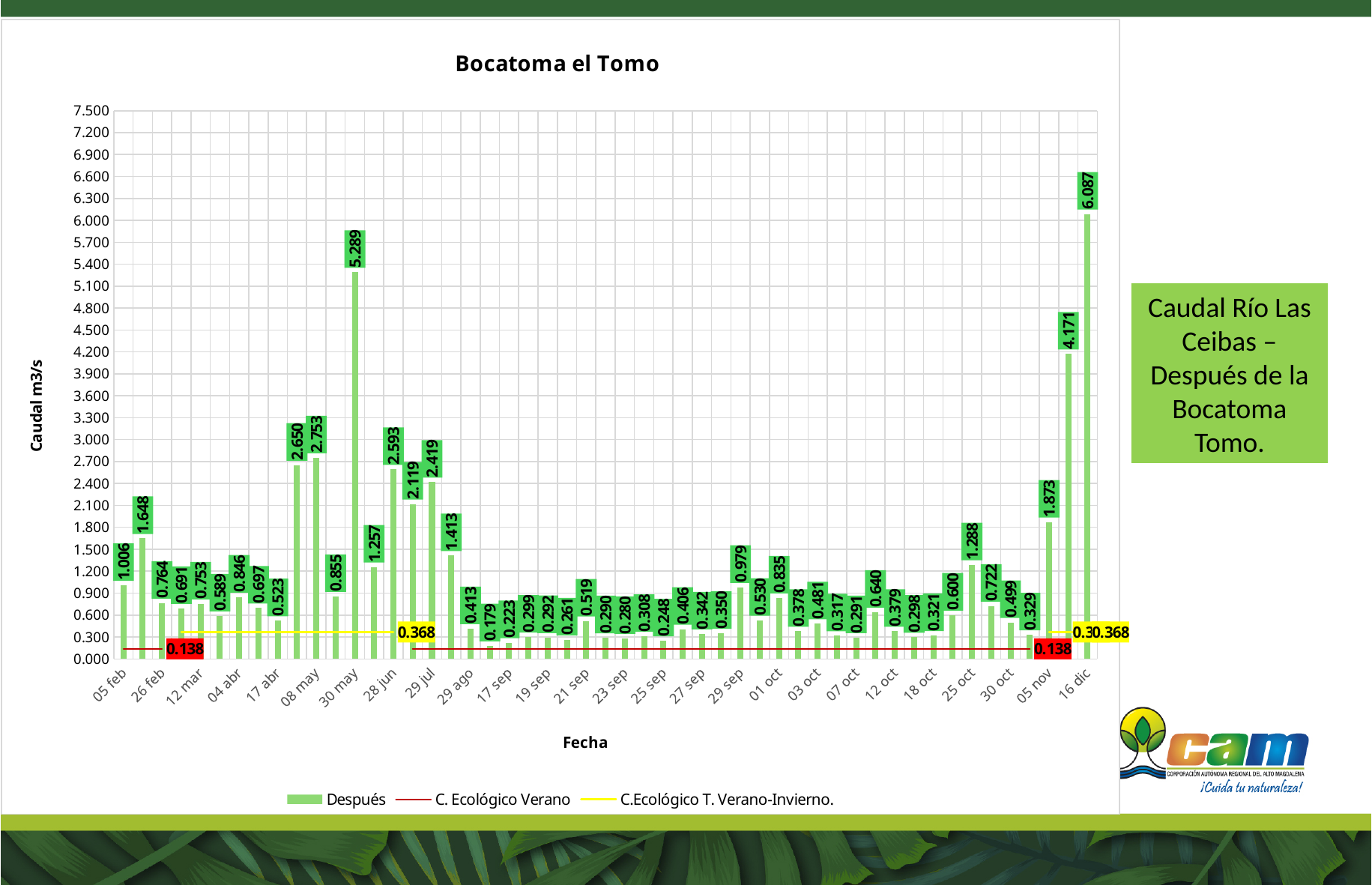
What is the Después value for 16 dic? 6.087 What is the highest value plotted for the Después series? 6.087 How many series does the legend list? 3 What is the label of the vertical axis? Caudal m3/s What value is shown for the C.Ecológico T. Verano-Invierno line? 0.368 What is the lowest value plotted for the Después series? 0.179 Which date has the larger Después value, 05 feb or 16 dic? 16 dic What is the title of the chart? Bocatoma el Tomo What kind of chart is shown on the slide? combination bar and line chart What is the Después value for 05 feb? 1.006 What is the difference between the highest Después value (6.087) and the second highest (5.289)? 0.798 What value is shown for the C. Ecológico Verano line? 0.138